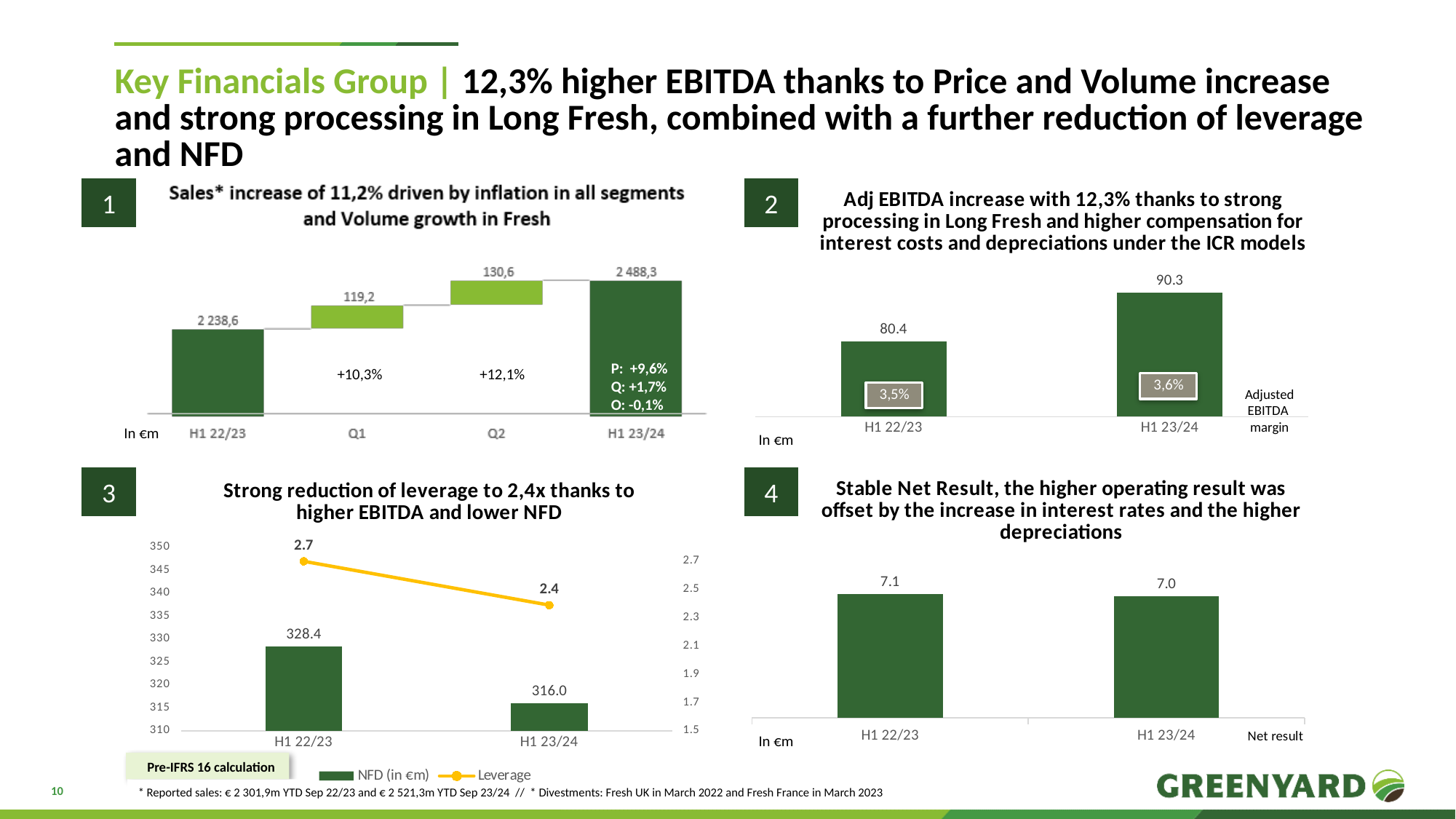
In the bottom-left leverage chart, what is the Leverage value for H1 23/24? 2.4 In the top-right Adj EBITDA chart, what is the value for H1 23/24? 90.3 In the top-left Sales chart, which is larger, the Q1 step or the Q2 step? Q2 In the top-right Adj EBITDA chart, what is the value for H1 22/23? 80.4 In the bottom-left leverage chart, does the NFD value rise or fall from H1 22/23 to H1 23/24? fall In the bottom-left leverage chart, what is the NFD value for H1 22/23? 328.4 In the top-left Sales chart, what is the value shown for Q2? 130,6 In the top-right Adj EBITDA chart, what Adjusted EBITDA margin is shown for H1 23/24? 3,6% In the bottom-right Net result chart, which period has the higher value? H1 22/23 In the top-right Adj EBITDA chart, what is the difference between the H1 23/24 and H1 22/23 values? 9.9 In the top-left Sales chart, what is the value for H1 23/24? 2 488,3 In the bottom-left leverage chart, how many series does the legend list? 2